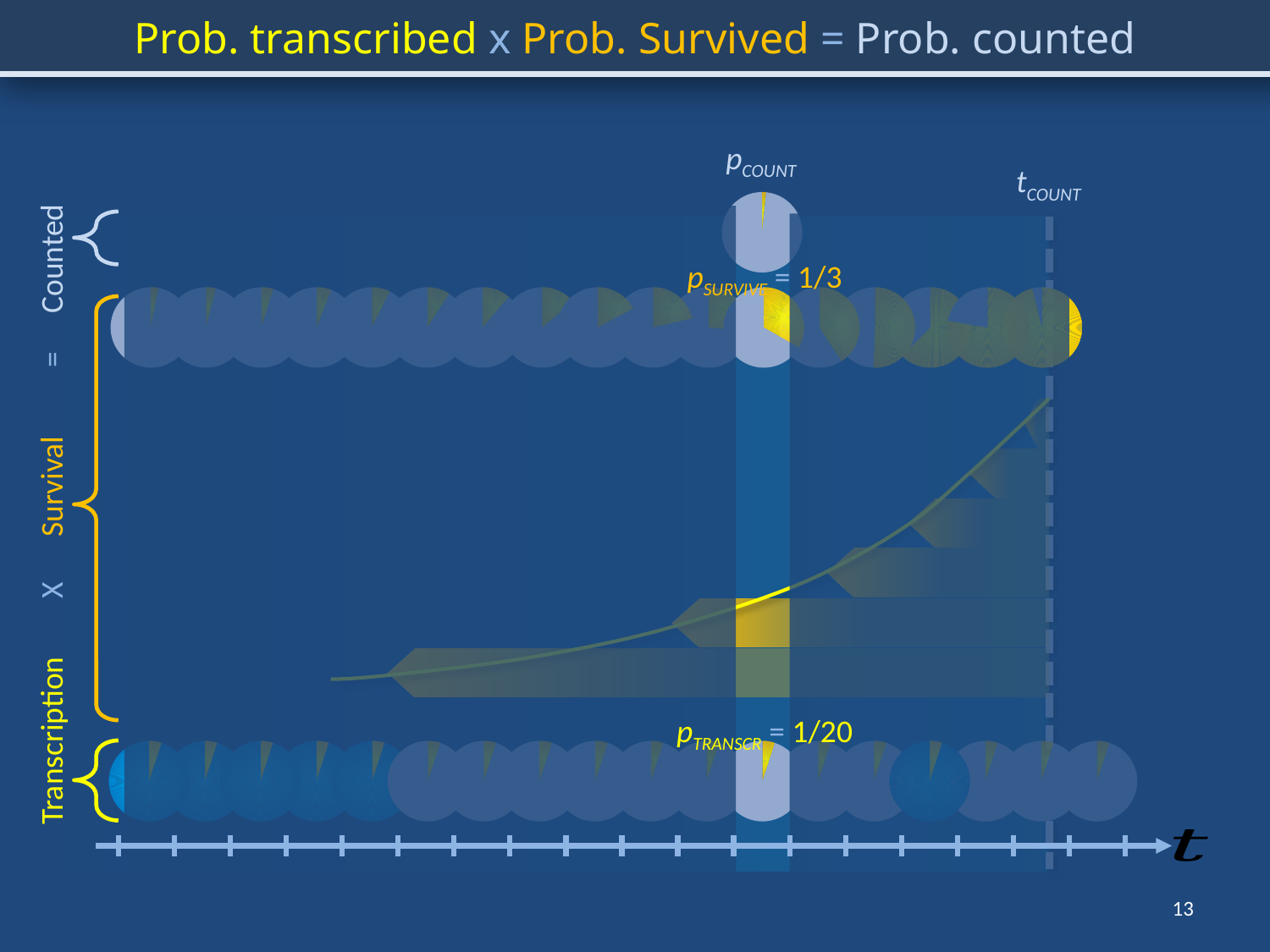
What value is printed for p_SURVIVE on the slide? 1/3 What label is shown at the end of the horizontal axis? t What is the title of the slide's diagram? Prob. transcribed x Prob. Survived = Prob. counted What label appears above the highlighted circle at the top of the diagram? p_COUNT What label is shown next to the vertical dashed line on the right of the diagram? t_COUNT Which printed probability is larger, p_SURVIVE or p_TRANSCR? p_SURVIVE What value is printed for p_TRANSCR on the slide? 1/20